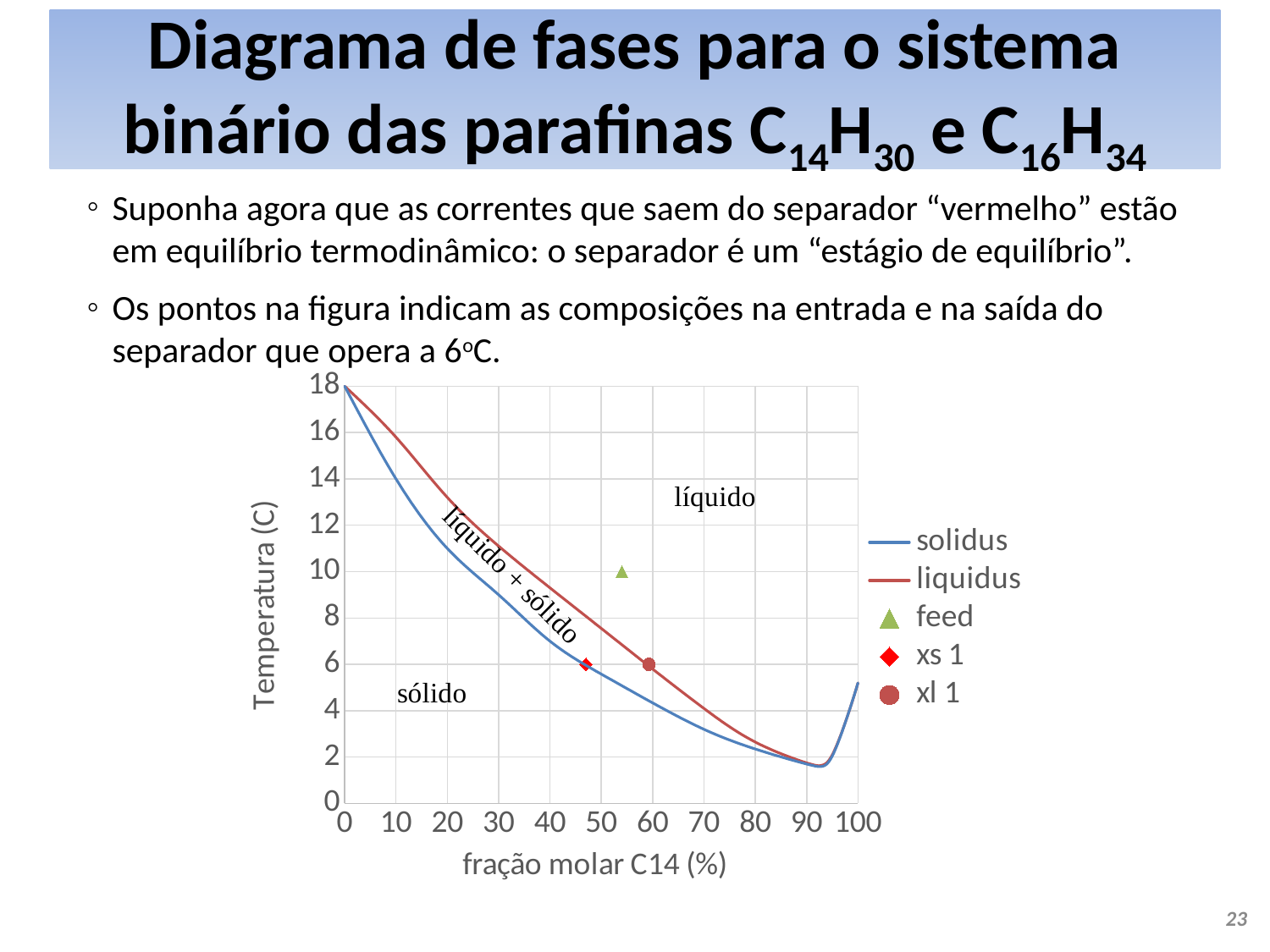
Is the fração molar C14 (%) of the xs 1 point greater or less than 50? less Is the fração molar C14 (%) of the feed point greater or less than 50? greater What are the legend entries of the chart? solidus, liquidus, feed, xs 1, xl 1 What temperature (C) is the xl 1 point plotted at? 6 What is the title of the x axis of the chart? fração molar C14 (%) Does the liquidus curve rise or fall as fração molar C14 increases from 0 to 90? fall Which point has a larger fração molar C14 (%), xs 1 or xl 1? xl 1 What temperature (C) is the feed point plotted at? 10 What kind of chart is shown on the slide? line chart How many series does the chart legend list? 5 Which of the plotted points (feed, xs 1, xl 1) has the highest temperature? feed What temperature (C) is the xs 1 point plotted at? 6